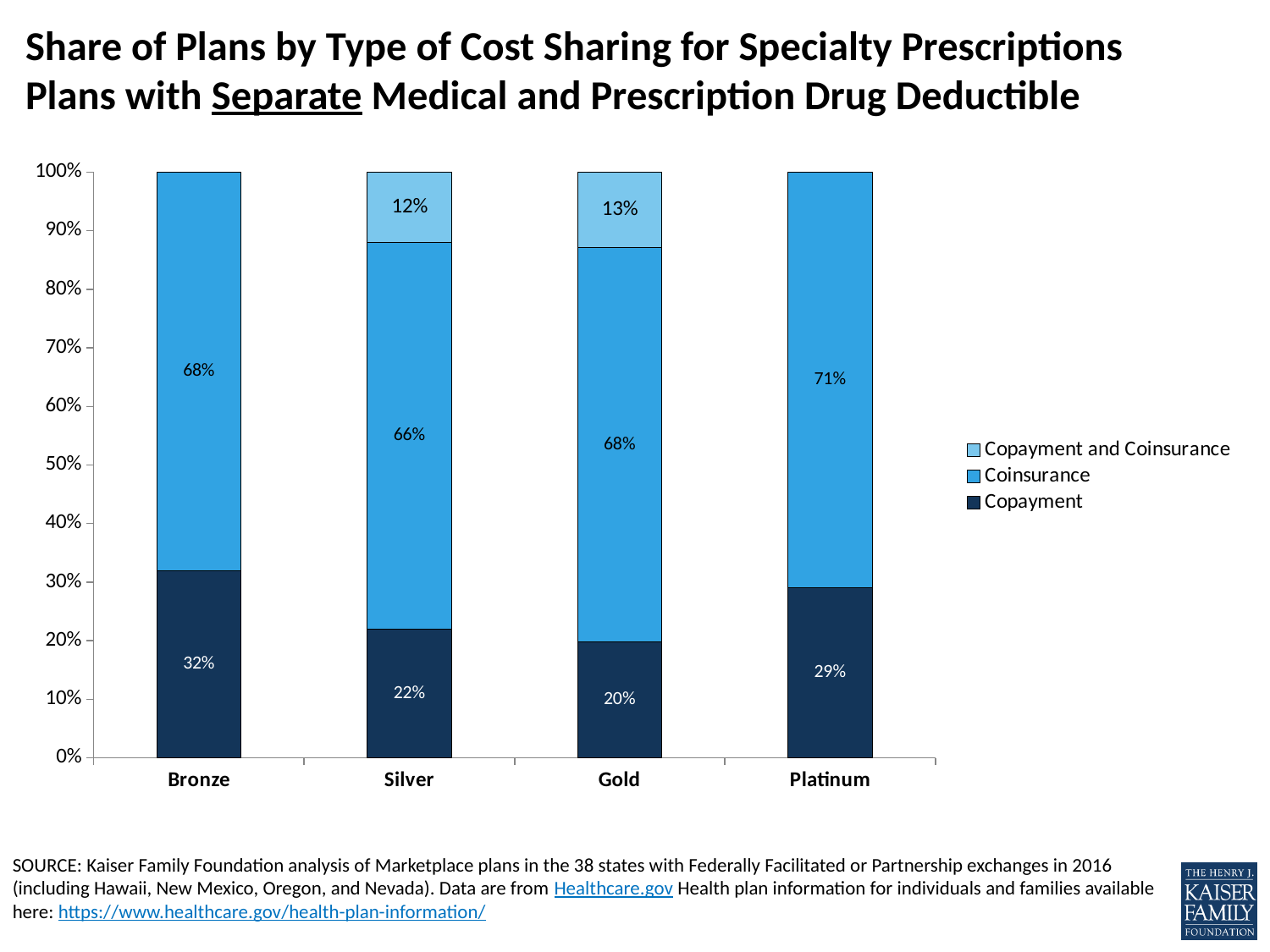
Which plan category has the lowest Copayment share? Gold What is the Coinsurance share for Platinum plans? 71% How many series does the legend list? 3 How many plan categories are shown on the x axis? 4 What is the Copayment and Coinsurance share for Gold plans? 13% What type of chart is shown on the slide? Stacked bar chart What is the total of the three labeled segments for the Silver bar? 100% What is the difference between the Copayment share for Bronze and for Gold? 12 percentage points Which plan category has the highest Copayment share? Bronze Which legend entry is shown in the darkest blue? Copayment What is the Copayment share for Bronze plans? 32% Which is larger, the Coinsurance share for Silver or for Platinum? Platinum